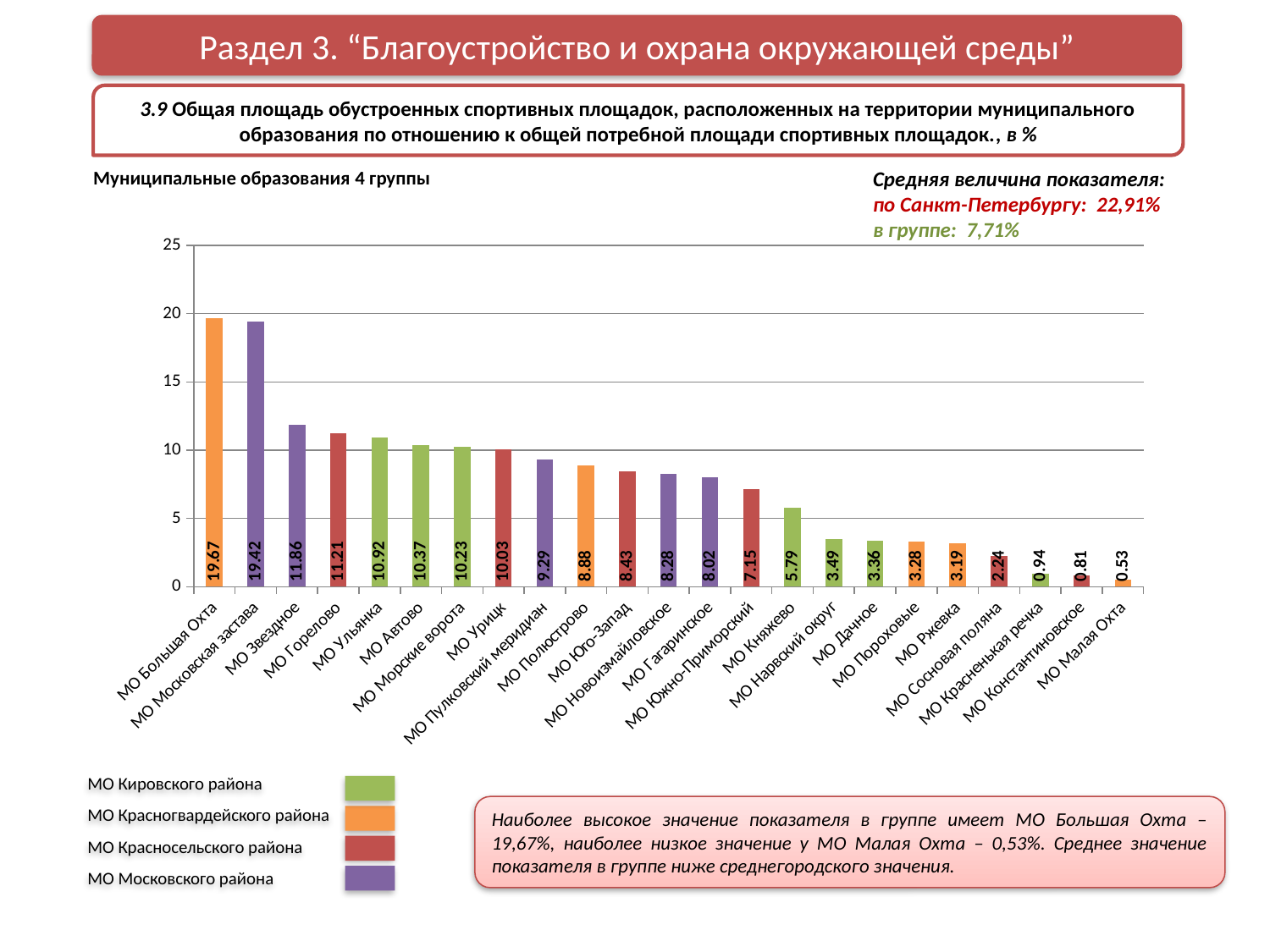
Which municipality has the lowest value on the chart? МО Малая Охта How many municipalities are shown on the chart? 23 Do the values rise or fall from left to right along the x axis? fall What is the difference between the values for МО Большая Охта and МО Московская застава? 0.25 Is the value for МО Пулковский меридиан greater or less than 10? less What is the value for МО Княжево? 5.79 What is the value for МО Сосновая поляна? 2.24 What kind of chart is shown on the slide? bar chart Which municipality has the highest value on the chart? МО Большая Охта Which has a larger value, МО Ульянка or МО Урицк? МО Ульянка What is the difference between the values for МО Горелово and МО Южно-Приморский? 4.06 What is the value for МО Звездное? 11.86